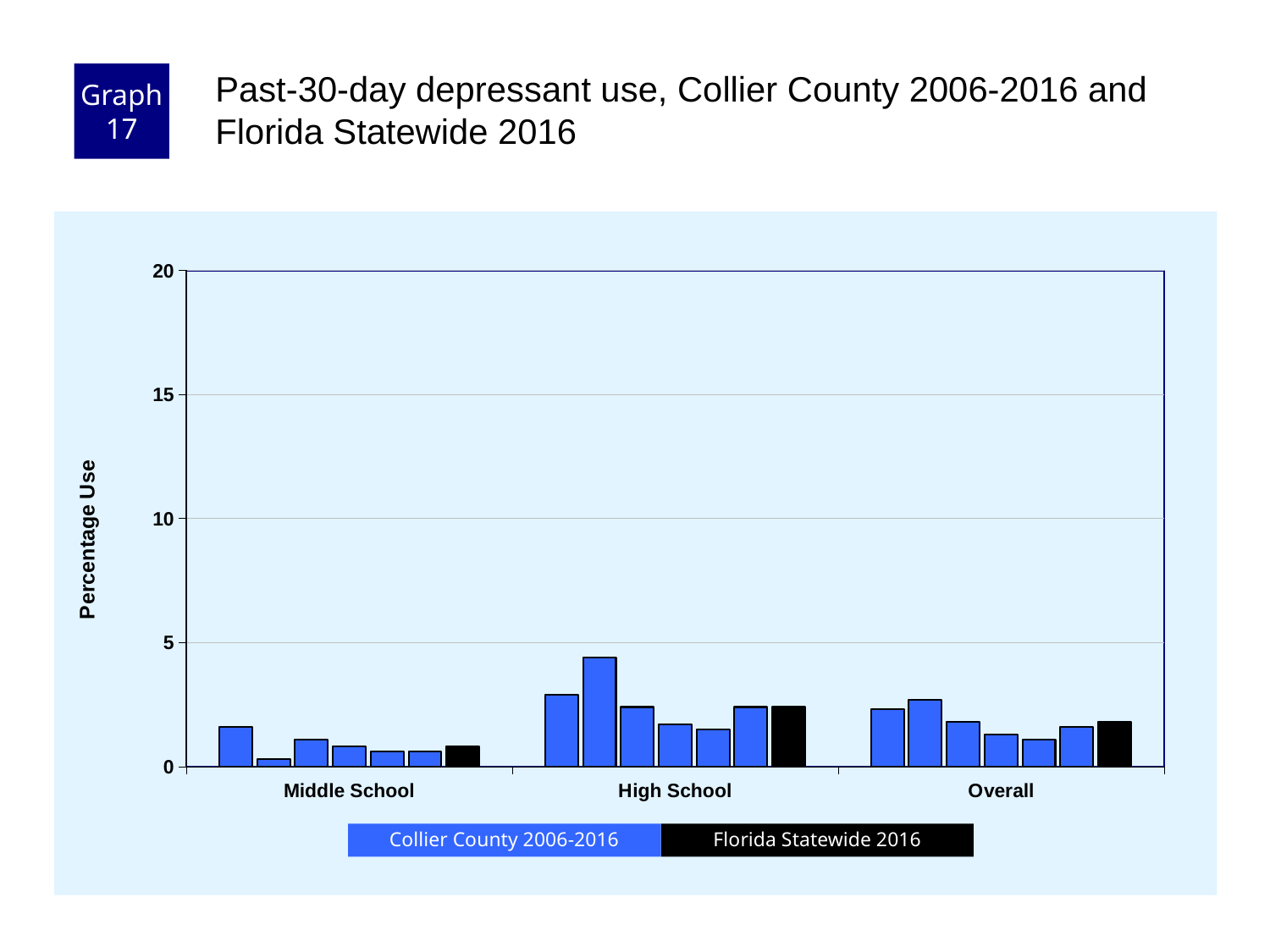
How many series does the chart's legend list? 2 What are the three categories on the x axis? Middle School, High School, Overall What kind of chart is shown on the slide? Bar chart Is the Florida Statewide 2016 bar larger for Overall or for Middle School? Overall What is the label on the y axis of the chart? Percentage Use Which x-axis category contains the tallest bar in the chart? High School Is the tallest Collier County bar in the High School group greater or less than 5? less How many categories are shown on the x axis of the chart? 3 Is the Florida Statewide 2016 value for Middle School greater or less than 5? less Which x-axis category has the lowest Florida Statewide 2016 bar? Middle School Is the Florida Statewide 2016 value for High School greater or less than 5? less Is the Florida Statewide 2016 bar larger for High School or for Middle School? High School